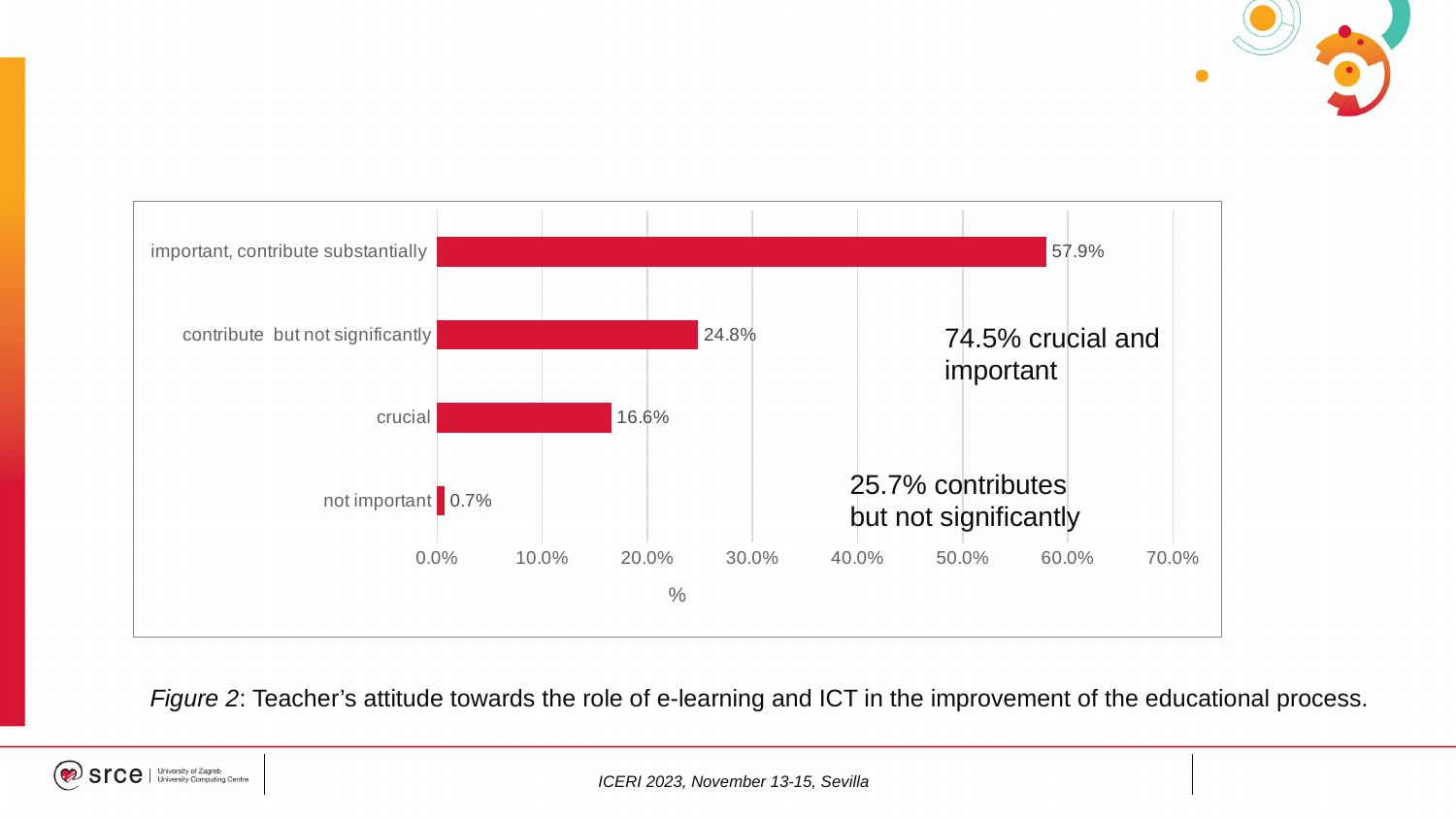
How many categories are shown in the chart? 4 What is the difference between the values for "important, contribute substantially" and "contribute but not significantly"? 33.1% Which category has the lowest value? not important What is the value for "contribute but not significantly"? 24.8% What is the label on the horizontal axis of the chart? % Which category has the highest value? important, contribute substantially Which is larger, the value for "crucial" or the value for "contribute but not significantly"? contribute but not significantly What is the value for "crucial"? 16.6% Is the value for "important, contribute substantially" greater or less than 50.0%? greater What kind of chart is shown on the slide? bar chart What is the value for "important, contribute substantially"? 57.9% What is the value for "not important"? 0.7%